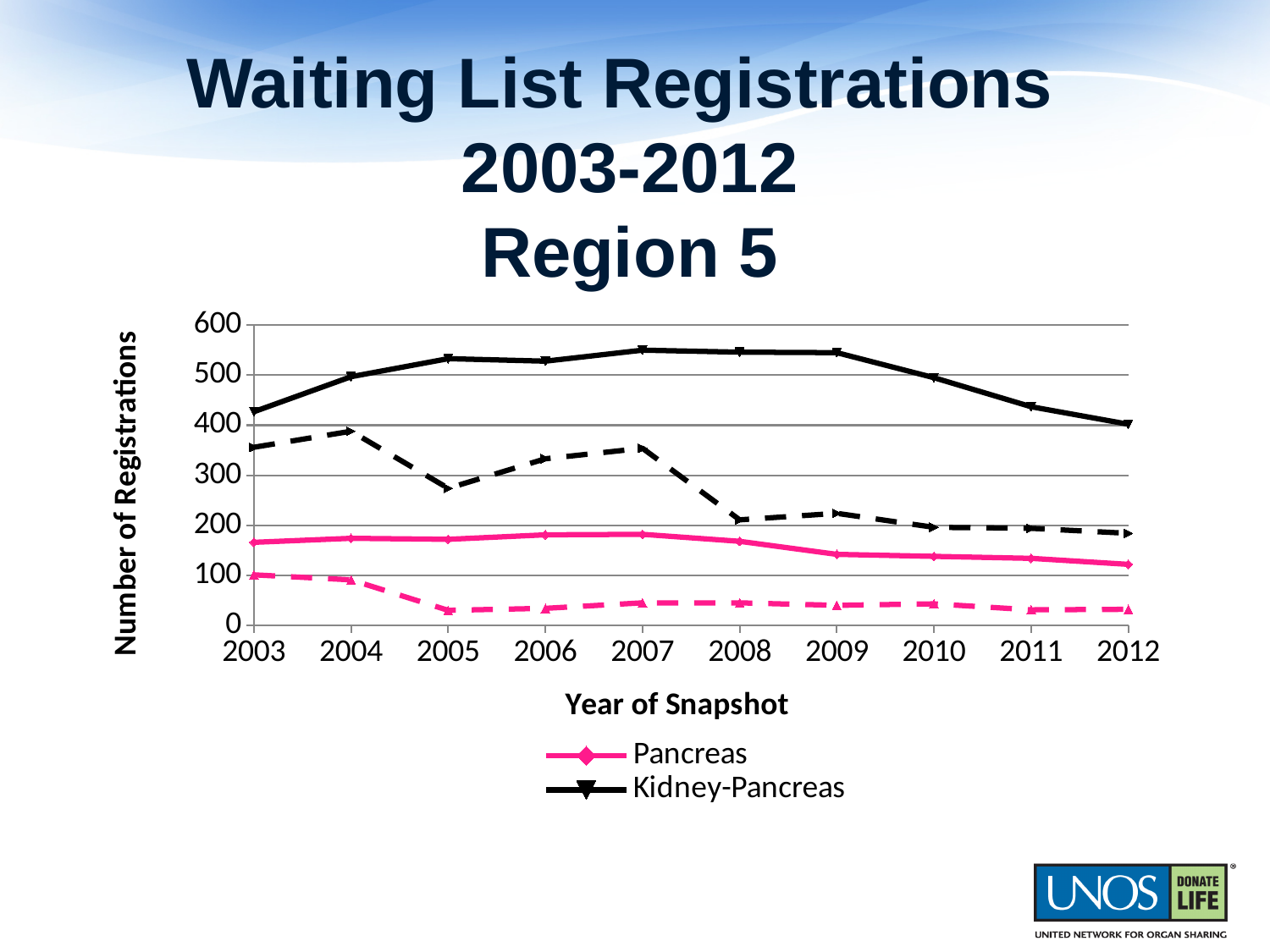
Is the Kidney-Pancreas value (solid black line) in 2007 greater or less than 500? greater How many series does the legend list? 2 What is the title of the y axis? Number of Registrations What kind of chart is shown on the slide? line chart Is the dashed black line's value in 2005 greater or less than 300? less What is the title of the x axis? Year of Snapshot Is the Kidney-Pancreas value (solid black line) in 2003 greater or less than 400? greater In 2007, which is larger: the Kidney-Pancreas solid line or the Pancreas solid line? Kidney-Pancreas Does the Kidney-Pancreas solid line rise or fall from 2009 to 2012? fall How many years are plotted along the x axis? 10